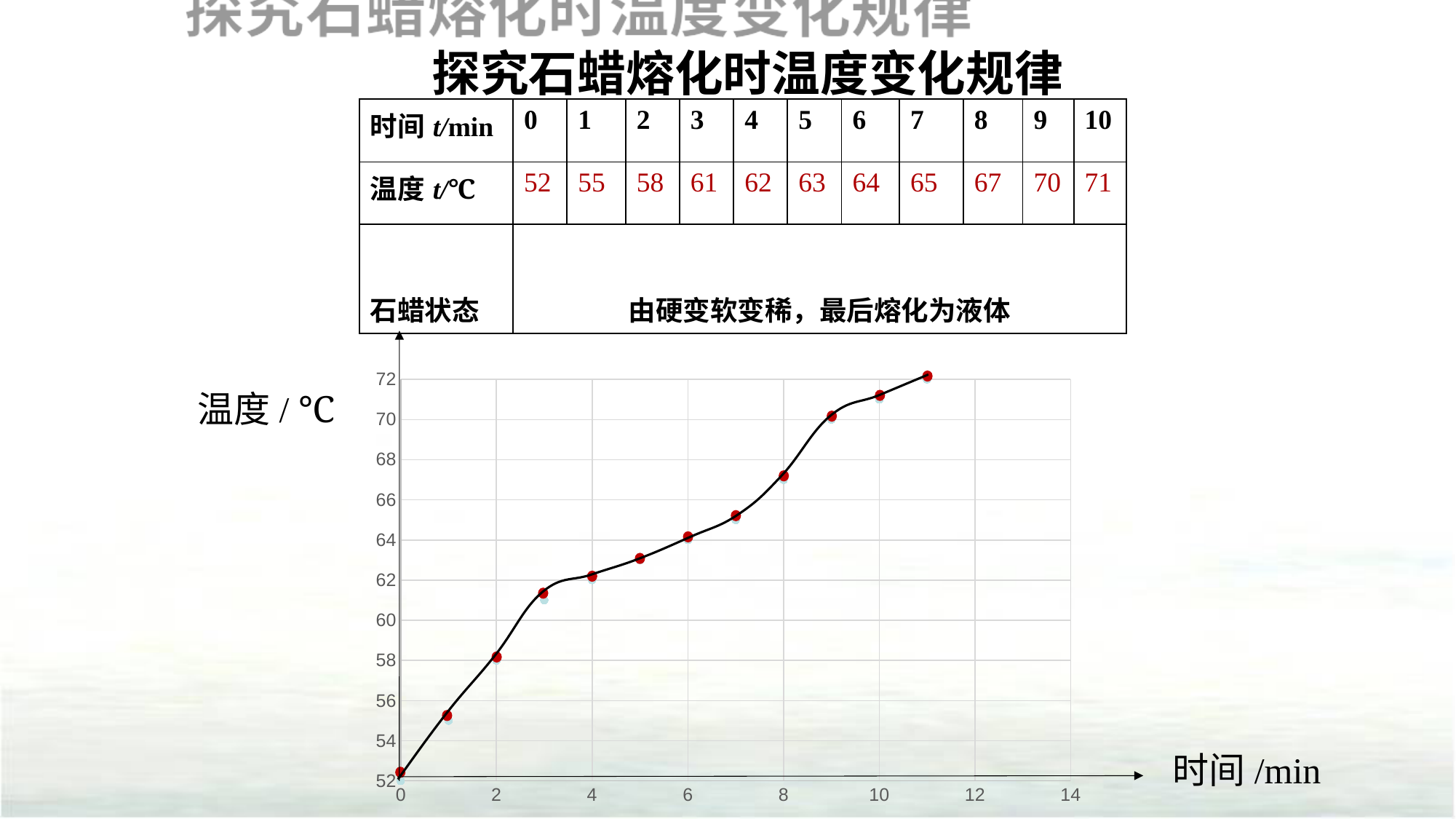
What is the label of the vertical axis of the chart? 温度 / ℃ Which is higher, the plotted temperature at 3 min or at 8 min? 8 min According to the table on the slide, what is the temperature at 9 min? 70 How many data points are plotted on the line chart? 12 Is the plotted temperature at 9 min greater or less than 68? greater At which time is the plotted temperature lowest? 0 min According to the table on the slide, what is the temperature at 5 min? 63 Is the plotted temperature at 6 min greater or less than 66? less What kind of chart is shown on the slide? line chart Using the table values, what is the difference between the temperature at 10 min and at 0 min? 19 Is the plotted temperature at 2 min greater or less than 60? less Do the plotted temperature values rise or fall as time increases along the x axis? rise